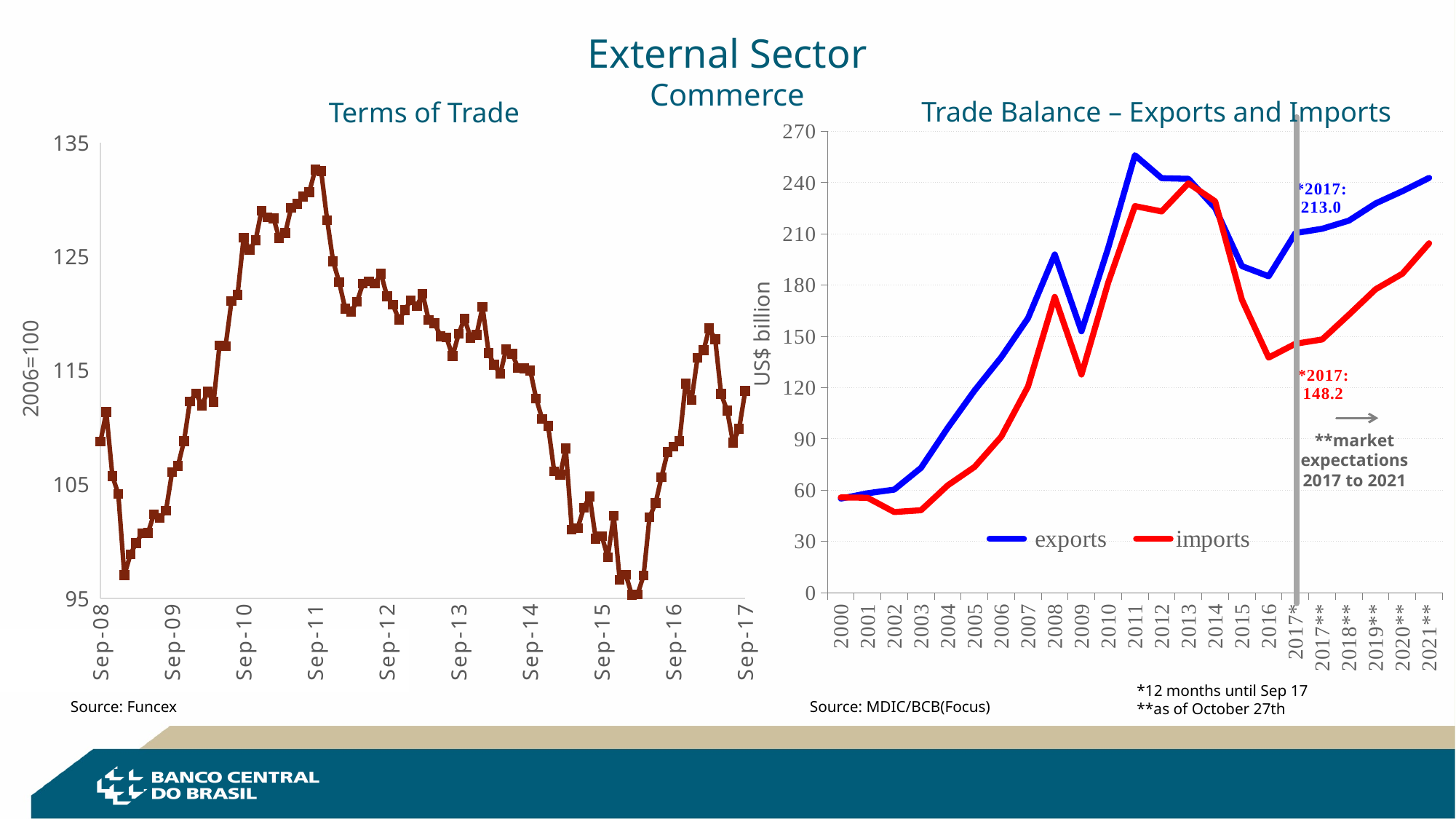
In the Trade Balance – Exports and Imports chart, which is larger in 2017*, exports or imports? exports In the Trade Balance – Exports and Imports chart, is the value of exports in 2011 greater or less than 240? greater In the Trade Balance – Exports and Imports chart, in which year do exports reach their highest value? 2011 In the Trade Balance – Exports and Imports chart, do exports rise or fall from 2017** to 2021**? rise What kind of chart is the Trade Balance – Exports and Imports chart? line chart In the Trade Balance – Exports and Imports chart, what is the labelled value of imports for 2017*? 148.2 In the Trade Balance – Exports and Imports chart, what is the labelled value of exports for 2017*? 213.0 What is the y-axis label of the Terms of Trade chart? 2006=100 How many series does the legend of the Trade Balance – Exports and Imports chart list? 2 In the Trade Balance – Exports and Imports chart, what is the difference between the labelled 2017* values for exports and imports? 64.8 In the Terms of Trade chart, is the value at Sep-11 greater or less than 125? greater In the Trade Balance – Exports and Imports chart, is the value of imports in 2002 greater or less than 60? less